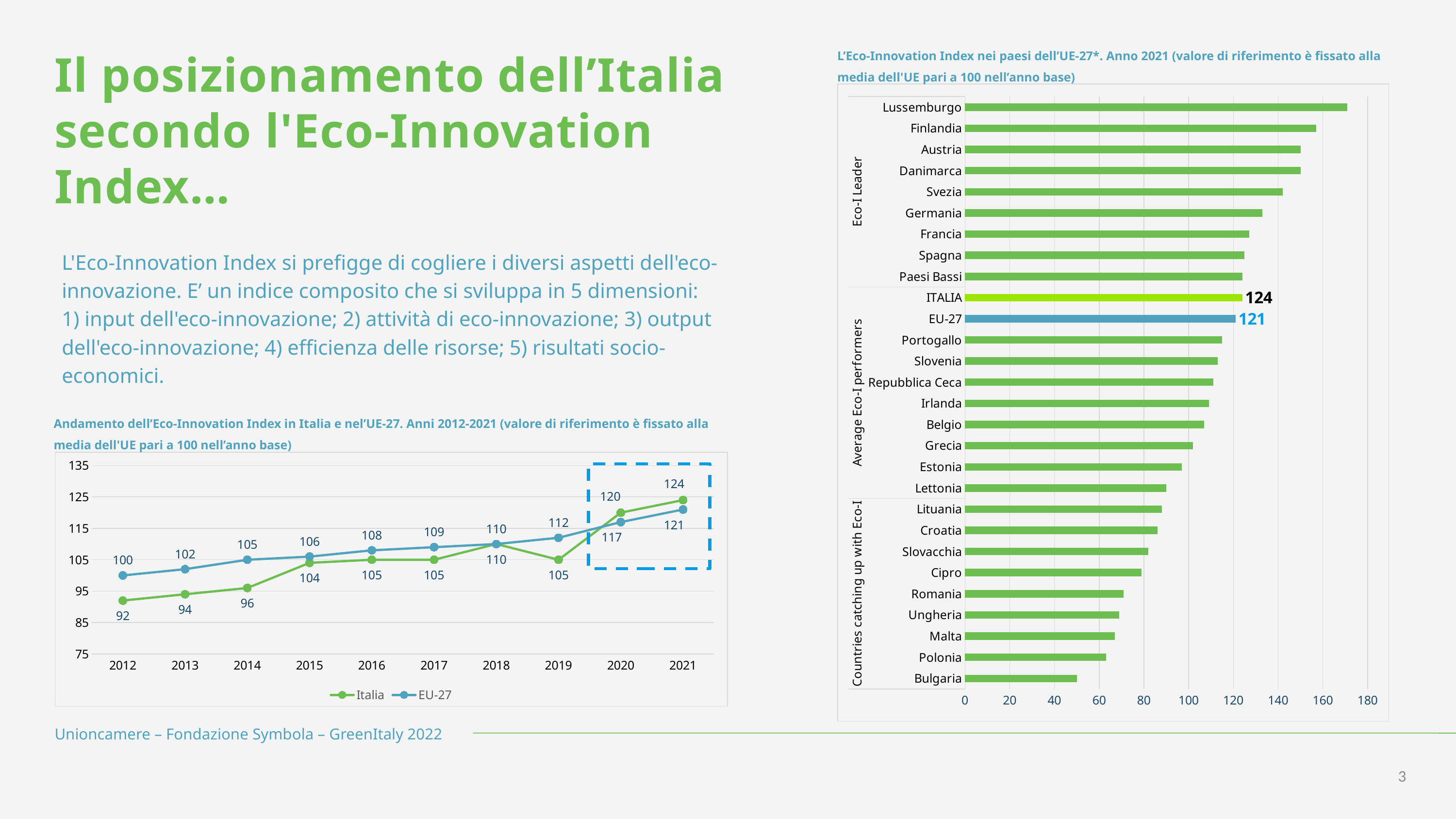
In the line chart on the left, what is the value for Italia in 2012? 92 In the bar chart on the right, which country has the lowest value? Bulgaria In the line chart on the left, what is the difference between Italia and EU-27 in 2021? 3 In the bar chart on the right, which country has the highest value? Lussemburgo In the line chart on the left, how many series does the legend list? 2 In the bar chart on the right, what is the value for ITALIA? 124 In the line chart on the left, in which year does Italia reach its highest value? 2021 In the line chart on the left, does the EU-27 series rise or fall from 2012 to 2021? rise In the line chart on the left, what is the value for EU-27 in 2019? 112 In the bar chart on the right, is the value for Finlandia greater or less than 140? greater In the line chart on the left, which is larger in 2015, Italia or EU-27? EU-27 What kind of chart is shown on the right side of the slide? bar chart